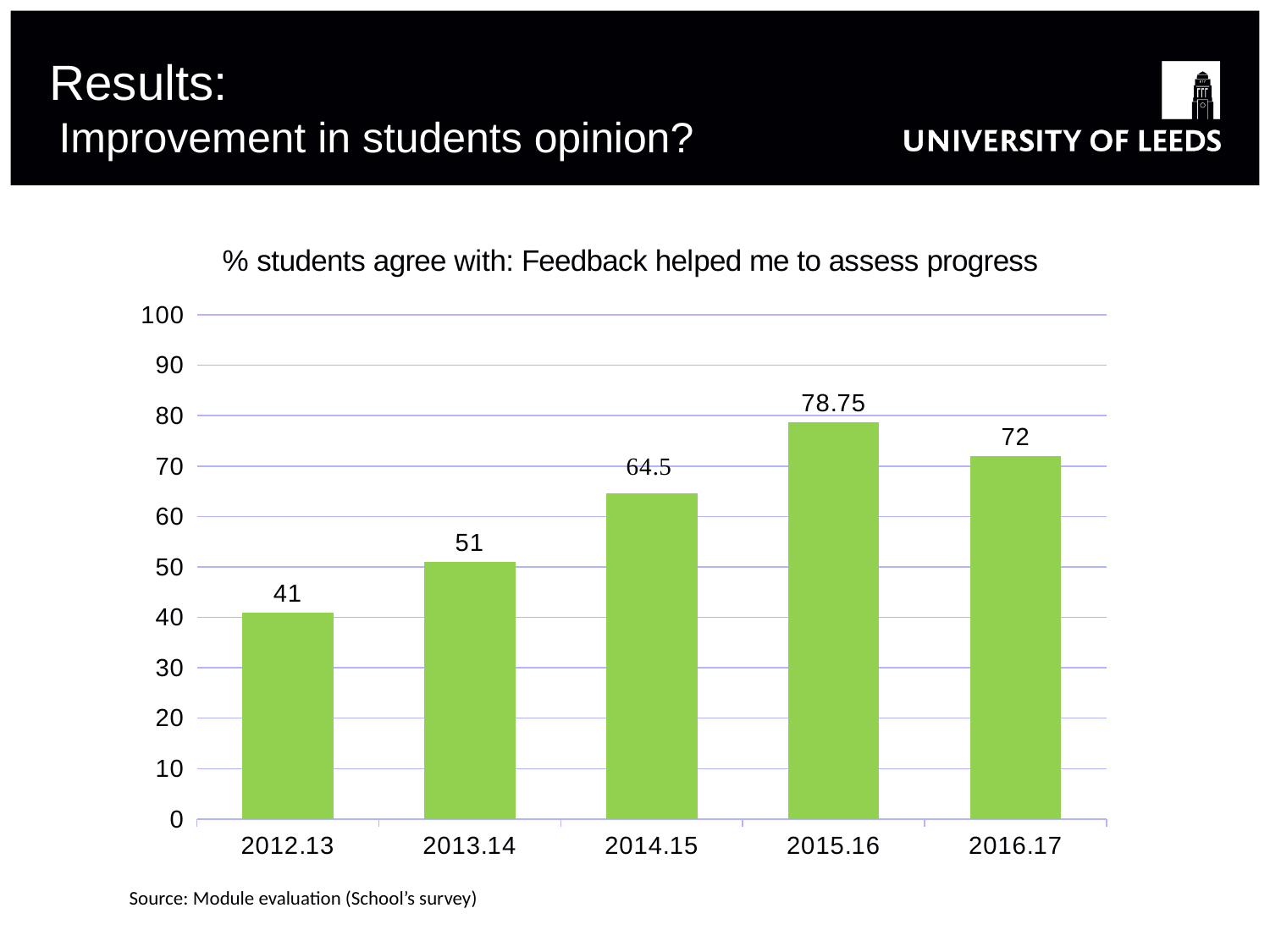
Which is larger, the value for 2014.15 or the value for 2016.17? 2016.17 What is the value for 2014.15? 64.5 Is the value for 2013.14 greater or less than 60? less What is the value for 2012.13? 41 How many years are shown on the x axis? 5 What is the difference between the values for 2015.16 and 2016.17? 6.75 Which year has the highest value? 2015.16 Which year has the lowest value? 2012.13 What is the difference between the values for 2013.14 and 2012.13? 10 What is the title of the chart? % students agree with: Feedback helped me to assess progress What kind of chart is shown on the slide? bar chart What is the value for 2015.16? 78.75